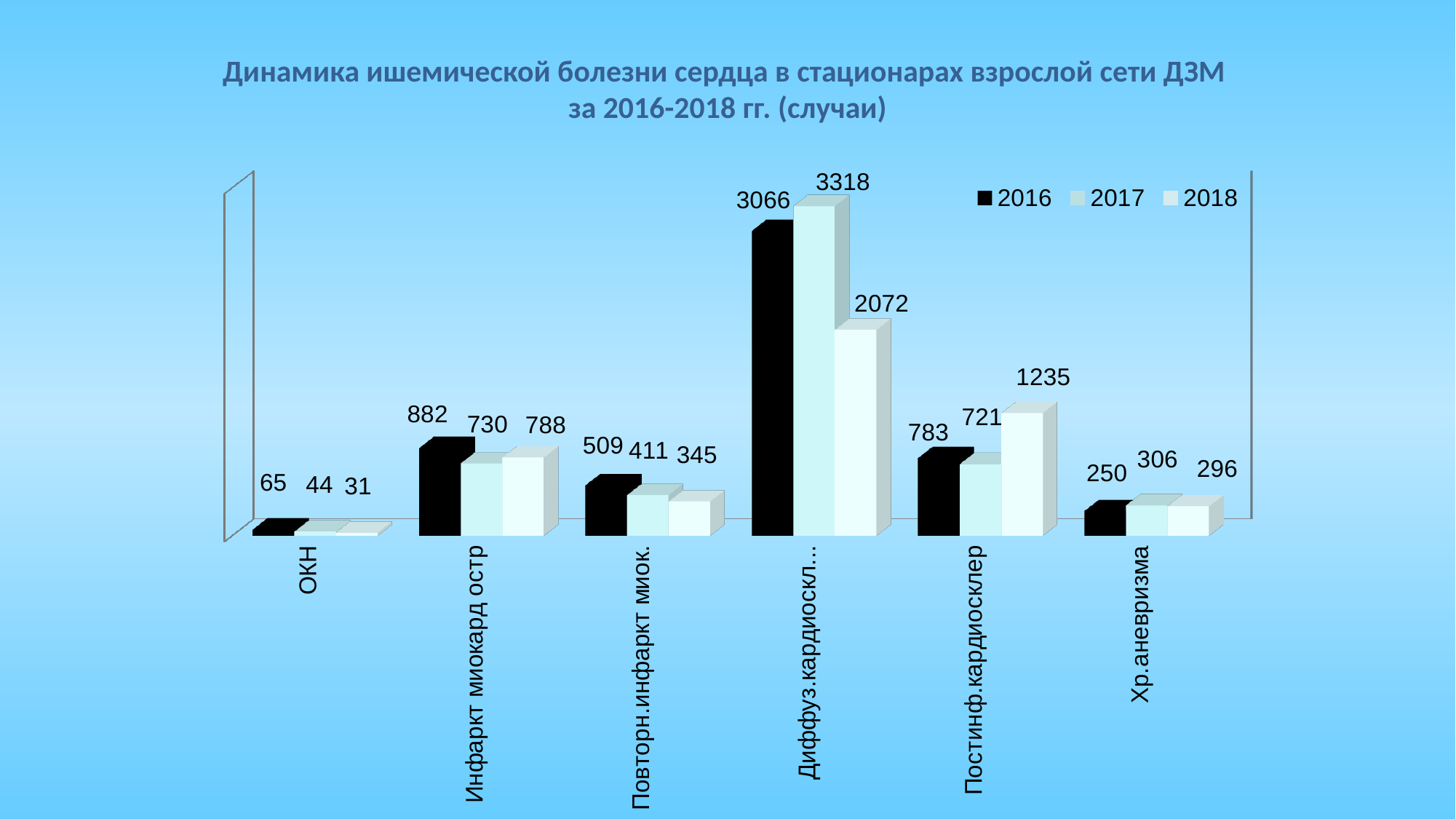
Do the values for Повторн.инфаркт миок. rise or fall from 2016 to 2018? Fall How many series does the legend list? 3 Which category has the highest value in the 2017 series? Диффуз.кардиоскл… Which is larger for Повторн.инфаркт миок.: the 2016 value or the 2018 value? 2016 What is the value for Постинф.кардиосклер in 2018? 1235 How many categories are shown on the x axis? 6 What kind of chart is shown on the slide? Bar chart Which category has the lowest value in the 2018 series? ОКН What is the value for ОКН in 2016? 65 What is the difference between the 2017 and 2018 values for Диффуз.кардиоскл…? 1246 What is the value for Хр.аневризма in 2017? 306 What is the difference between the 2016 and 2017 values for Инфаркт миокард остр? 152